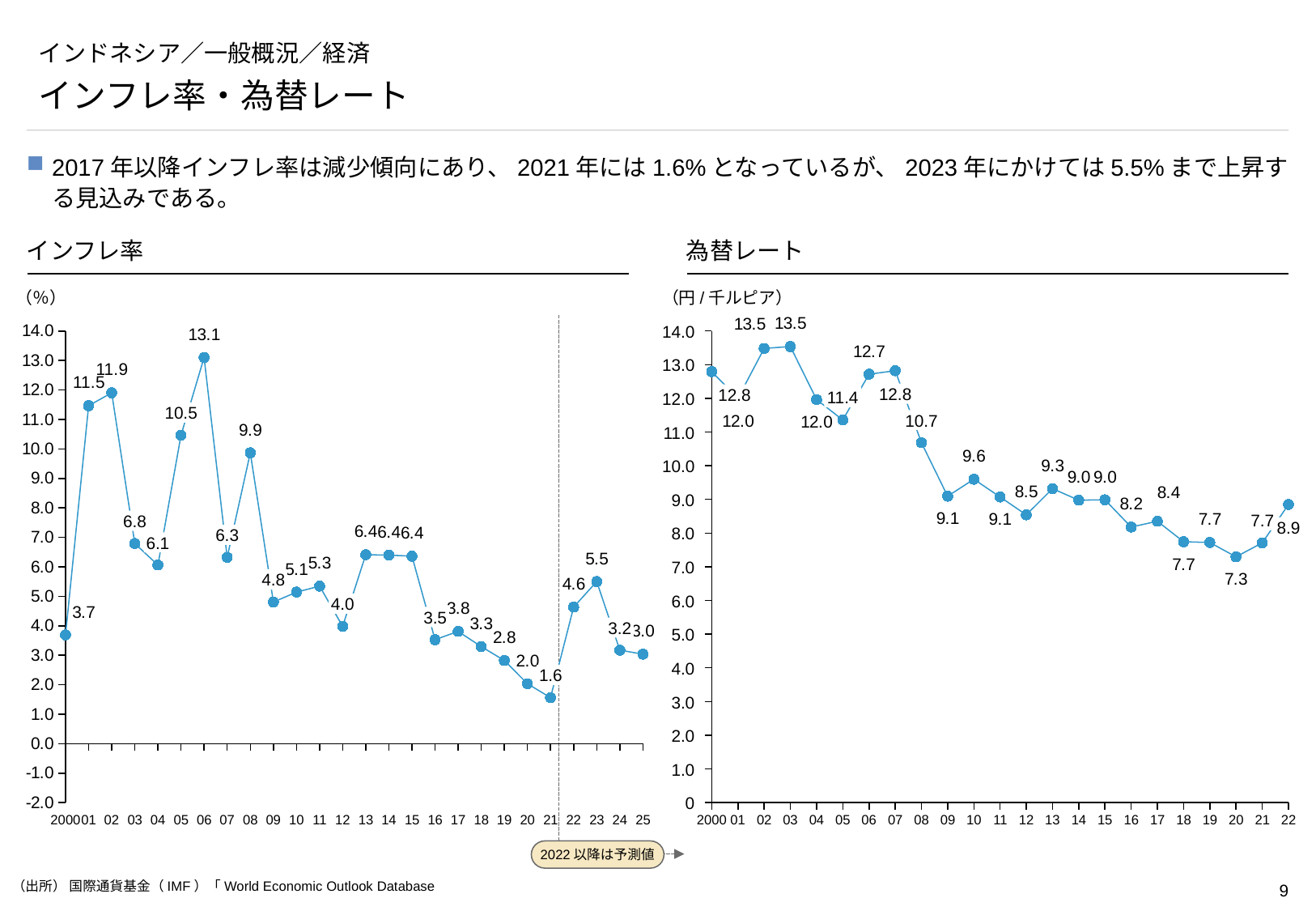
What kind of chart is the 為替レート chart on the right? Line chart In the 為替レート chart on the right, is the value for 2008 greater or less than 10.0? greater In the インフレ率 chart on the left, which is larger, the value for 2001 or the value for 2002? 2002 In the 為替レート chart on the right, what unit is shown on the y axis? 円/千ルピア In the インフレ率 chart on the left, what is the inflation rate for 2021? 1.6 In the 為替レート chart on the right, what is the difference between the 2022 value and the 2021 value? 1.2 In the インフレ率 chart on the left, what is the lowest inflation rate shown? 1.6 In the 為替レート chart on the right, what is the value for 2020? 7.3 In the インフレ率 chart on the left, what is the difference between the 2006 value and the 2007 value? 6.8 In the インフレ率 chart on the left, what is the inflation rate for 2023? 5.5 In the インフレ率 chart on the left, which year has the highest inflation rate? 2006 In the 為替レート chart on the right, which year has the lowest value? 2020